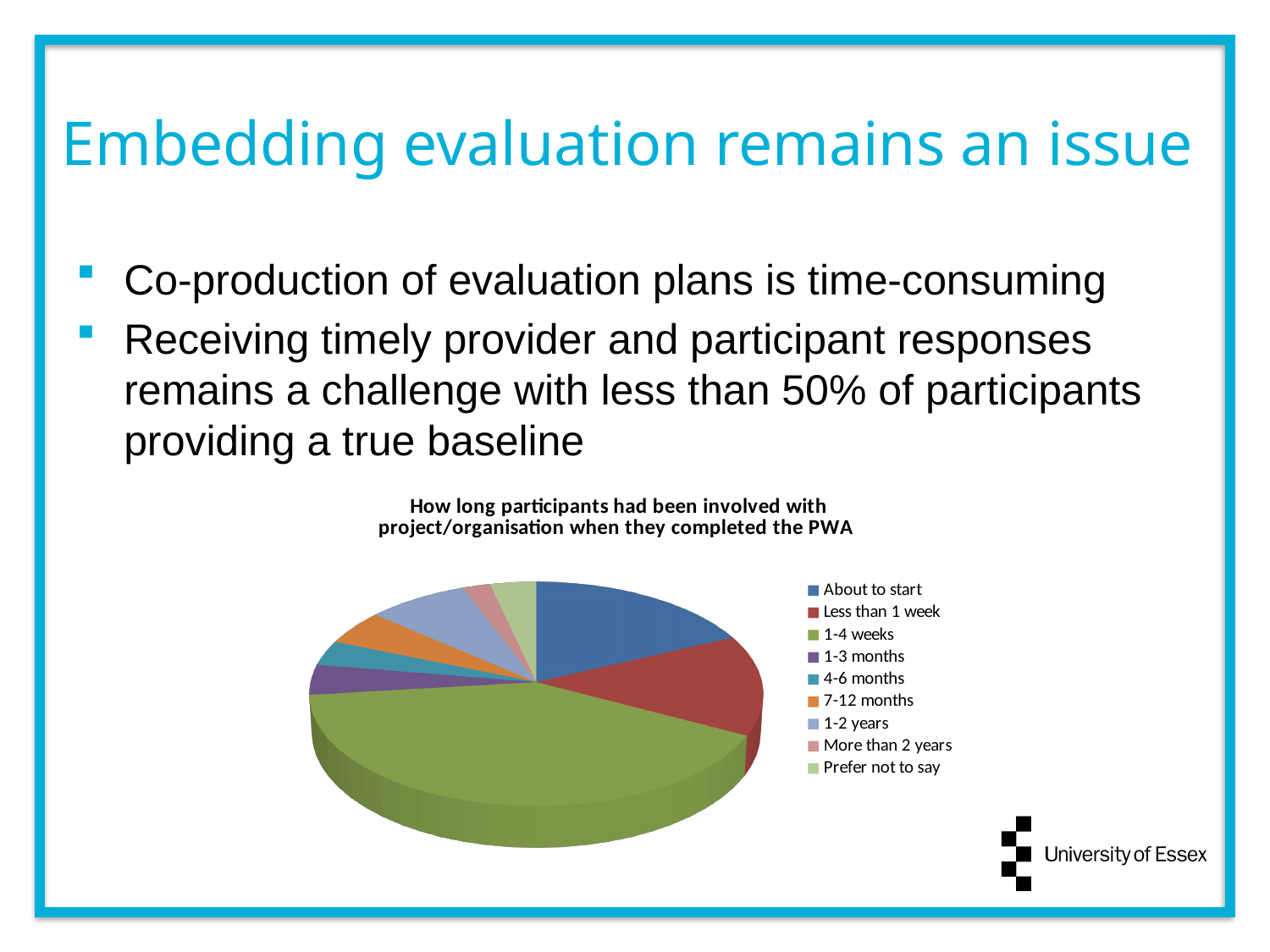
Which slice is larger in the pie chart: 1-4 weeks or Less than 1 week? 1-4 weeks What colour is the 1-4 weeks slice in the pie chart? Green Which category is listed last in the pie chart's legend? Prefer not to say What kind of chart is shown on the slide? Pie chart Which category has the largest slice in the pie chart? 1-4 weeks Which category is listed first in the pie chart's legend? About to start Which slice is larger in the pie chart: 1-4 weeks or About to start? 1-4 weeks Which slice is larger in the pie chart: About to start or 1-3 months? About to start How many categories does the pie chart's legend list? 9 What is the title of the pie chart? How long participants had been involved with project/organisation when they completed the PWA